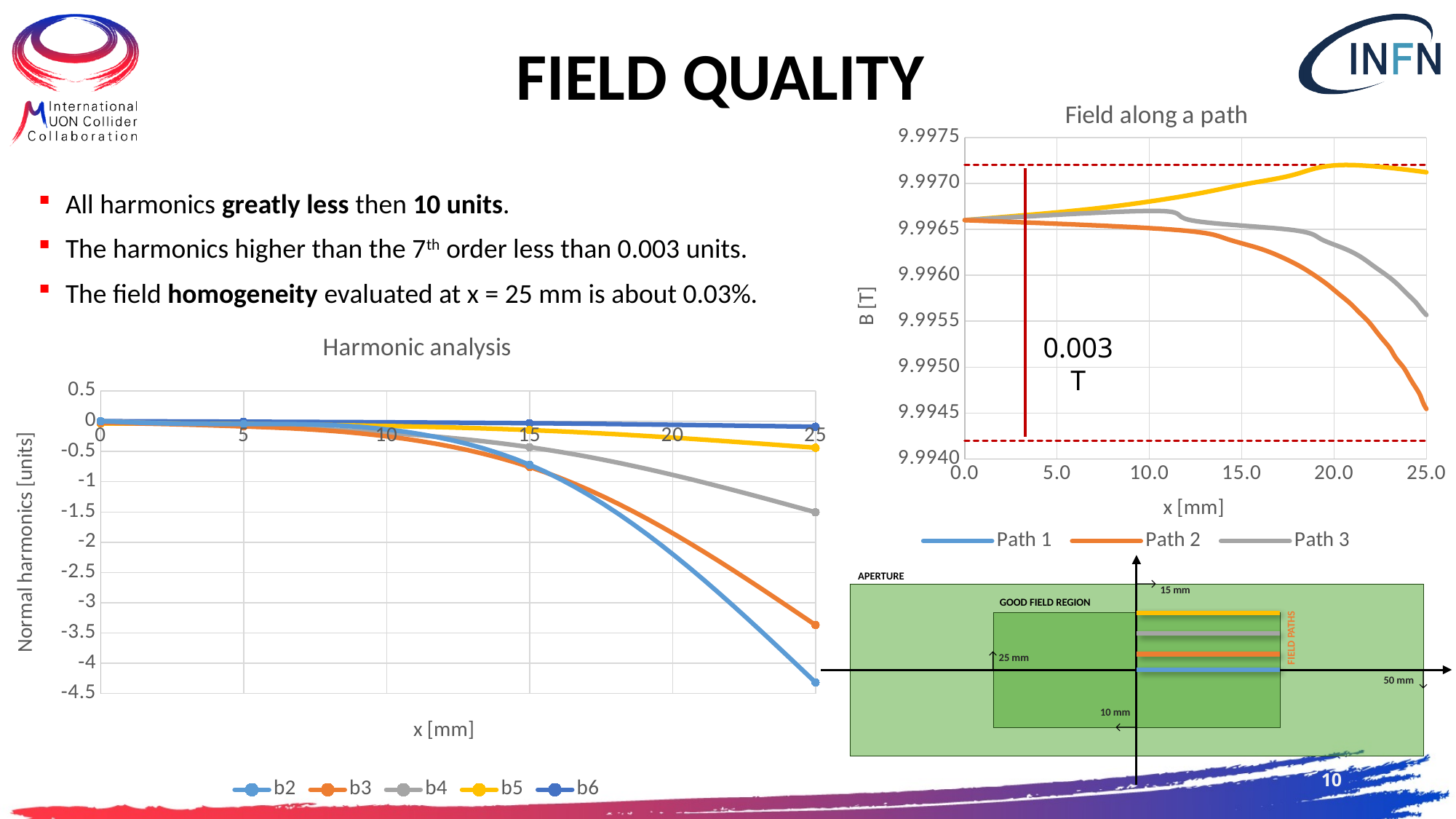
How many data points (markers) does each series in the "Harmonic analysis" chart have? 4 In the "Field along a path" chart, is the value of Path 2 at x = 25.0 greater or less than 9.9950? less In the "Field along a path" chart, which is larger at x = 25.0, Path 2 or Path 3? Path 3 In the "Harmonic analysis" chart, which series has the lowest value at x = 25? b2 How many series does the legend of the "Field along a path" chart list? 3 In the "Harmonic analysis" chart, is the value of b2 at x = 25 greater or less than -4? less In the "Harmonic analysis" chart, does the b2 series rise or fall as x increases? fall How many series does the legend of the "Harmonic analysis" chart list? 5 What is the y-axis title of the "Harmonic analysis" chart? Normal harmonics [units] In the "Harmonic analysis" chart, which is larger at x = 25, b3 or b4? b4 What kind of chart is the "Harmonic analysis" chart? line chart In the "Harmonic analysis" chart, is the value of b4 at x = 25 greater or less than -2? greater